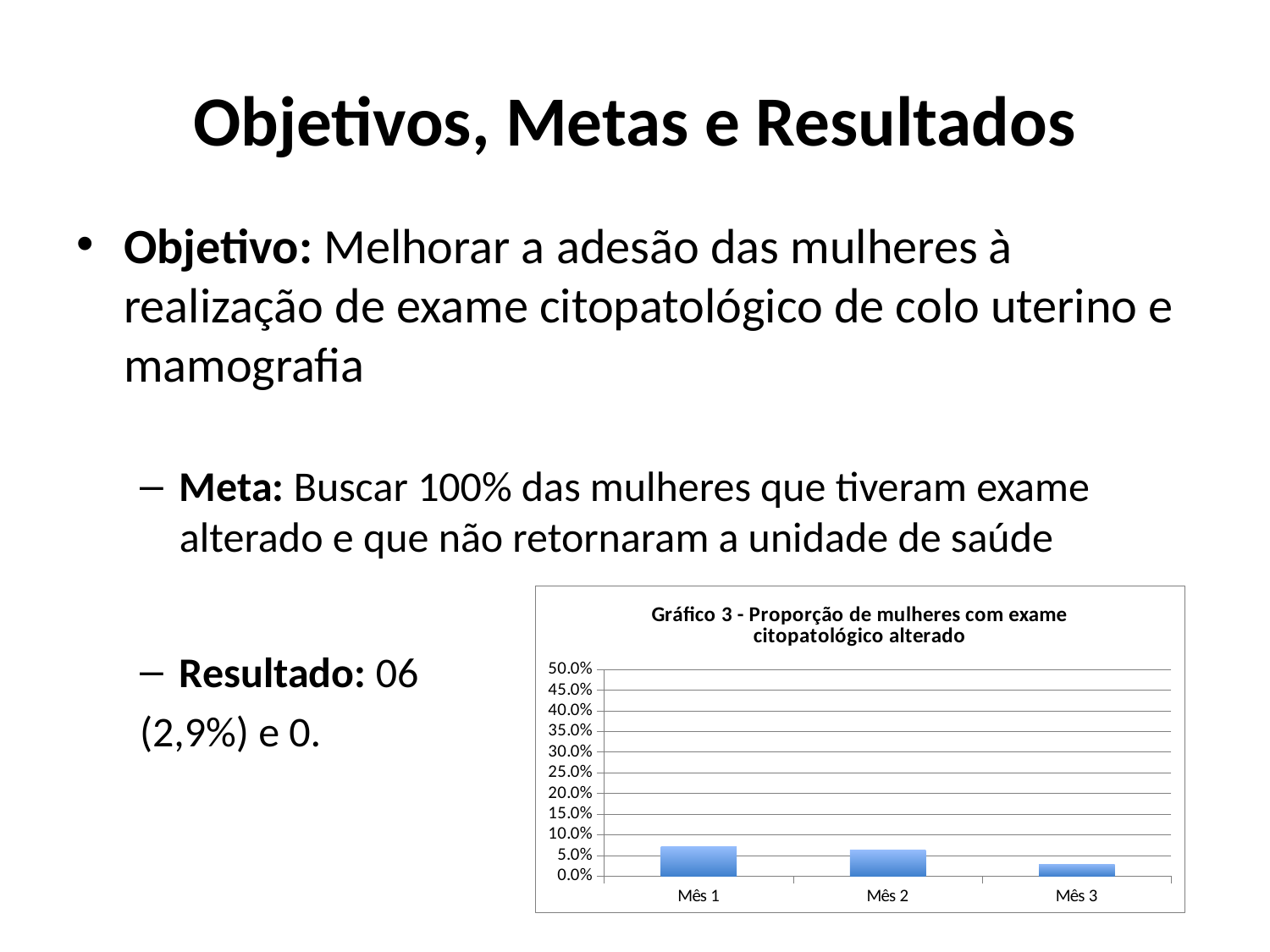
What is the title of the chart? Gráfico 3 - Proporção de mulheres com exame citopatológico alterado Is the value for Mês 1 greater or less than 10.0%? less Which is larger, the value for Mês 2 or the value for Mês 3? Mês 2 Which is larger, the value for Mês 1 or the value for Mês 3? Mês 1 What kind of chart is shown on the slide? bar chart Is the value for Mês 2 greater or less than 10.0%? less Which month has the lowest value in the chart? Mês 3 How many categories are plotted on the x axis of the chart? 3 What is the highest value shown on the chart's y axis? 50.0% Is the value for Mês 3 greater or less than 5.0%? less Do the values rise or fall from Mês 1 to Mês 3? fall